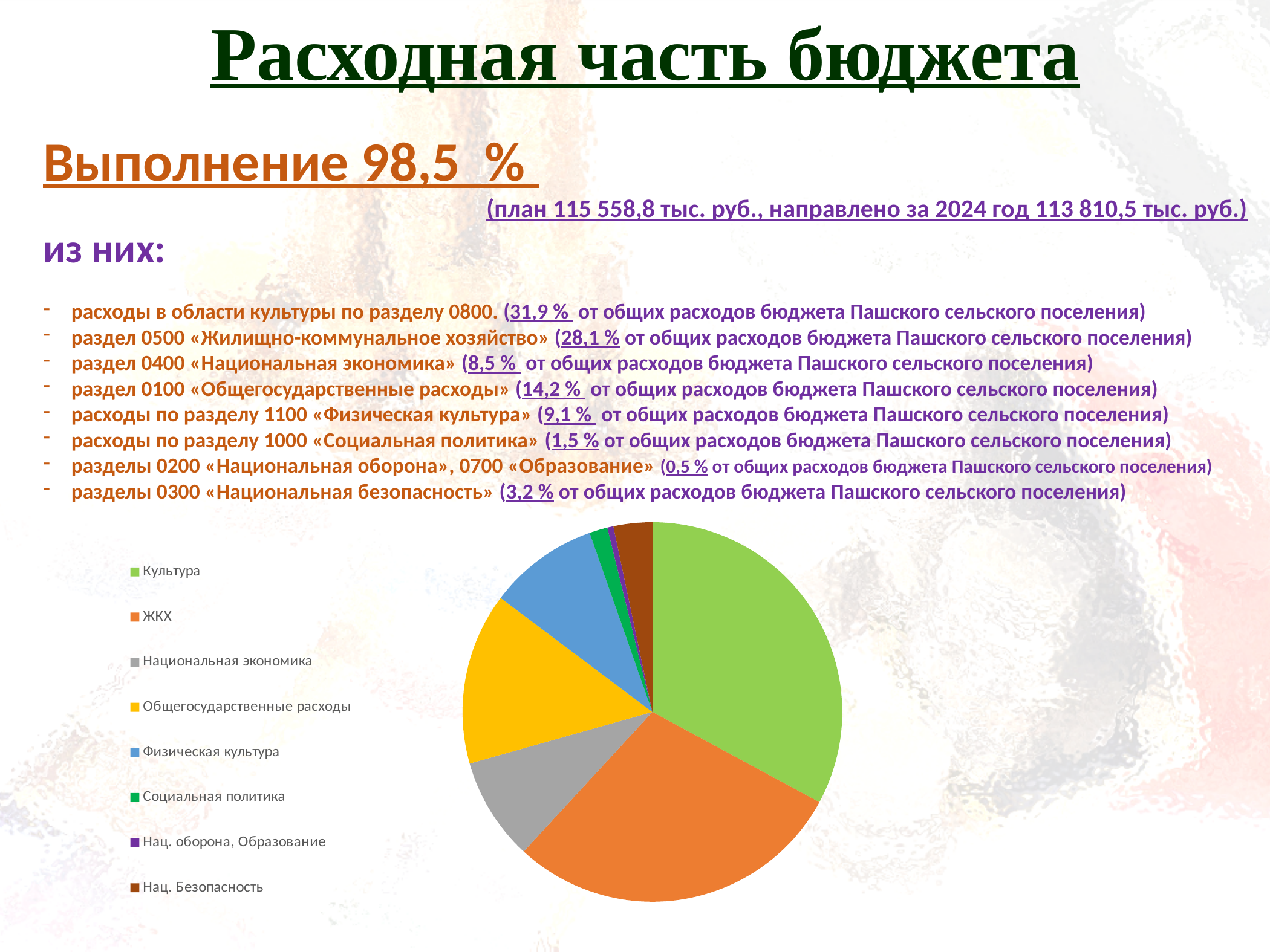
How many categories does the legend of the pie chart list? 8 According to the slide, what share of total budget expenditure does Нац. Безопасность (раздел 0300) account for? 3,2 % Which slice is larger in the pie chart: Нац. Безопасность or Социальная политика? Нац. Безопасность Which category has the smallest slice of the pie chart? Нац. оборона, Образование What colour is the Культура slice in the pie chart? green What colour is the ЖКХ slice in the pie chart? orange According to the slide, what share of total budget expenditure does Культура (раздел 0800) account for? 31,9 % Which slice is larger in the pie chart: Культура or ЖКХ? Культура Which category has the largest slice of the pie chart? Культура What kind of chart is shown on the slide? pie chart According to the slide, what share of total budget expenditure does ЖКХ (раздел 0500) account for? 28,1 % Which slice is larger in the pie chart: Общегосударственные расходы or Физическая культура? Общегосударственные расходы